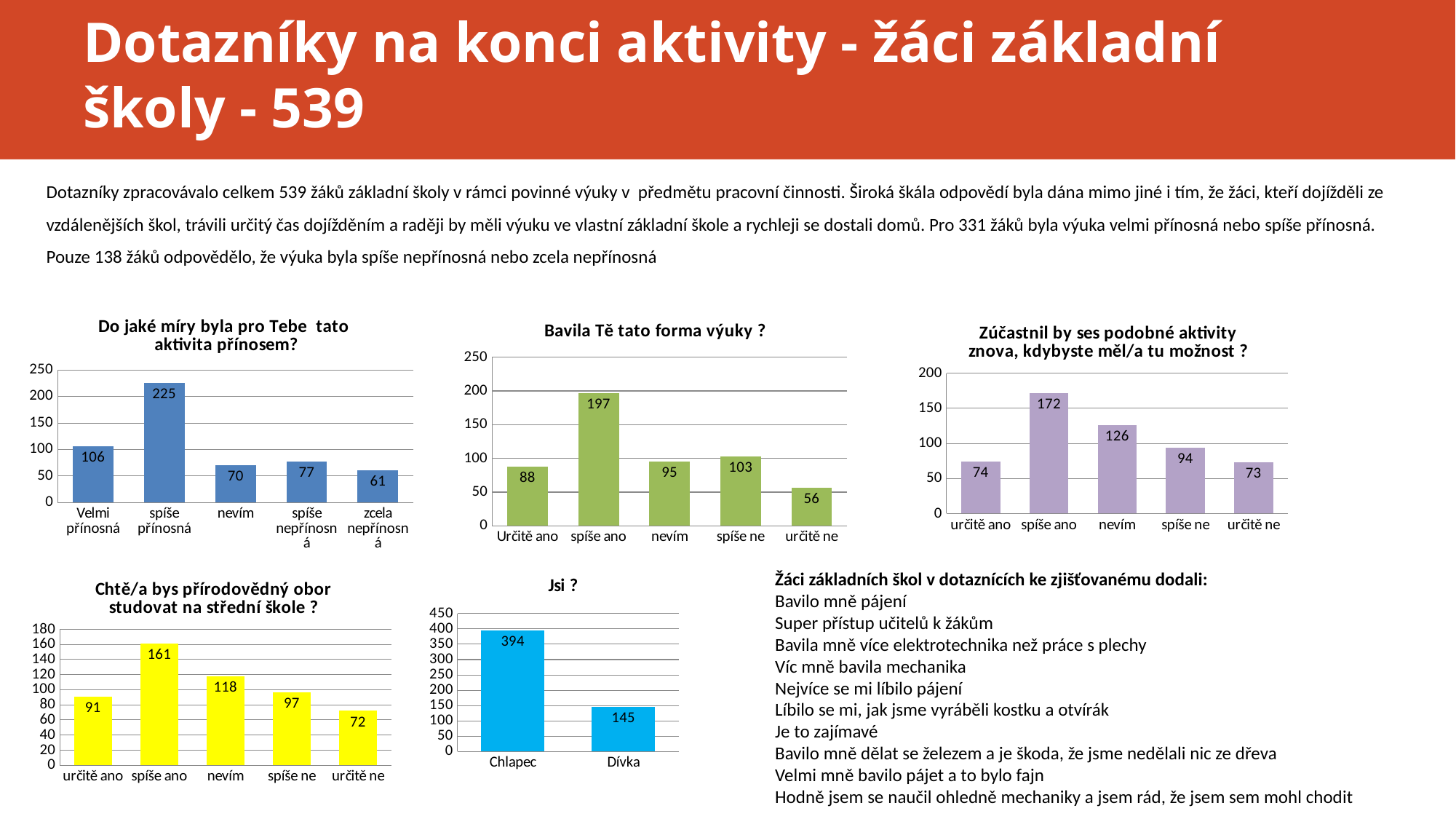
In the chart titled "Zúčastnil by ses podobné aktivity znova, kdybyste měl/a tu možnost ?", which is larger: "nevím" or "spíše ne"? nevím In the chart titled "Chtě/a bys přírodovědný obor studovat na střední škole ?", what is the value for "nevím"? 118 In the chart titled "Zúčastnil by ses podobné aktivity znova, kdybyste měl/a tu možnost ?", which category has the highest value? spíše ano What colour are the bars in the chart titled "Chtě/a bys přírodovědný obor studovat na střední škole ?"? yellow In the chart titled "Bavila Tě tato forma výuky ?", what is the difference between "spíše ano" and "určitě ne"? 141 In the chart titled "Do jaké míry byla pro Tebe tato aktivita přínosem?", which category has the lowest value? zcela nepřínosná In the chart titled "Do jaké míry byla pro Tebe tato aktivita přínosem?", what is the value for "spíše přínosná"? 225 In the chart titled "Jsi ?", what is the value for "Dívka"? 145 In the chart titled "Chtě/a bys přírodovědný obor studovat na střední škole ?", how many categories are shown? 5 In the chart titled "Jsi ?", what is the difference between "Chlapec" and "Dívka"? 249 In the chart titled "Bavila Tě tato forma výuky ?", what is the value for "spíše ne"? 103 What type of chart is the chart titled "Jsi ?"? bar chart